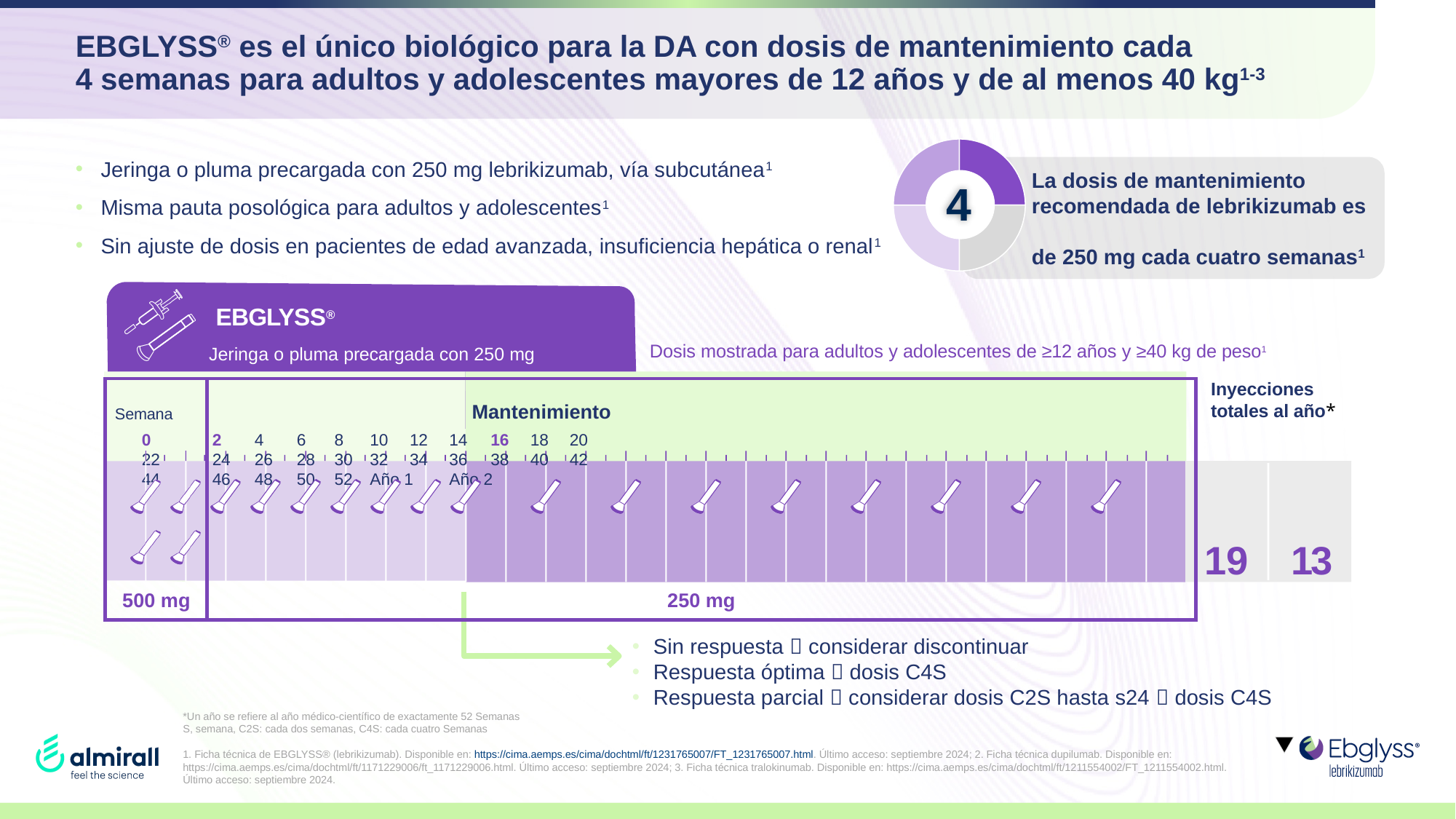
In the dosing schedule diagram, how many total injections per year are shown for Año 2? 13 In the dosing schedule diagram, at which week does the maintenance phase begin? 16 In the dosing schedule diagram, what dose is shown during the maintenance phase? 250 mg What is the label of the phase shaded in green in the dosing schedule diagram? Mantenimiento In the dosing schedule diagram, how many total injections per year are shown for Año 1? 19 In the dosing schedule diagram, which year has more total injections, Año 1 or Año 2? Año 1 In the dosing schedule diagram, what dose is shown for week 0? 500 mg In the dosing schedule diagram, what is the difference in total injections per year between Año 1 and Año 2? 6 What number is shown in the centre of the circular graphic at the top right of the slide? 4